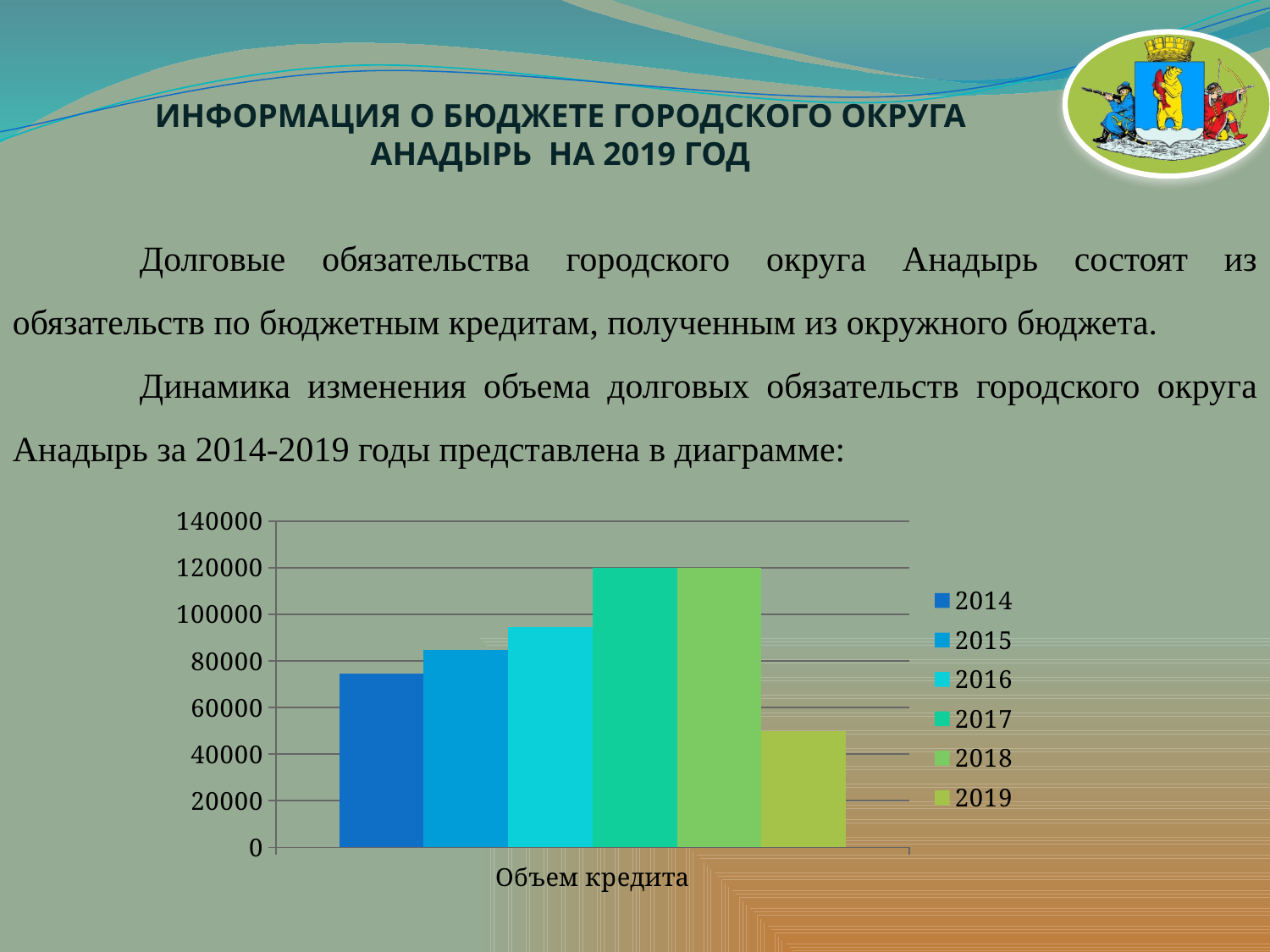
Which year has the lowest value in the chart? 2019 How many categories are shown on the x axis of the chart? 1 Is the value for 2015 greater or less than 80000? greater What kind of chart is shown on the slide? bar chart What is the category label shown on the x axis of the chart? Объем кредита Is the value for 2014 greater or less than 80000? less Is the value for 2017 greater or less than 100000? greater Which is larger, the value for 2016 or the value for 2019? 2016 Which is larger, the value for 2014 or the value for 2015? 2015 How many series does the legend of the chart list? 6